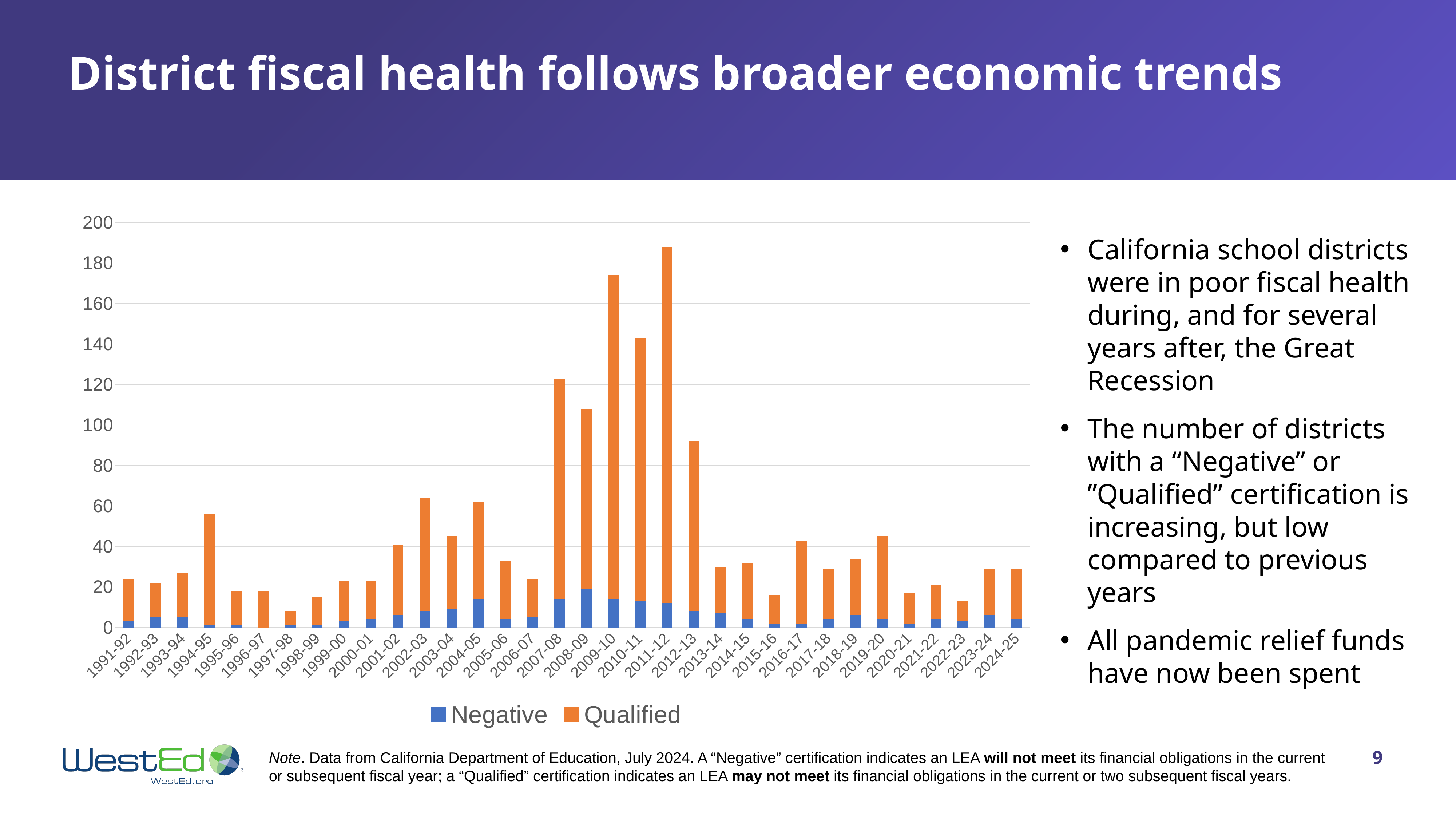
Which fiscal year has the larger total bar, 2009-10 or 2010-11? 2009-10 Is the total bar height for 2011-12 greater or less than 180? greater What kind of chart is shown on the slide? Stacked bar chart Which fiscal year has the tallest stacked bar in the chart? 2011-12 Which fiscal year has the larger total bar, 1994-95 or 1995-96? 1994-95 What are the two series named in the chart legend? Negative and Qualified Which fiscal year has the shortest stacked bar in the chart? 1997-98 Is the total bar height for 2009-10 greater or less than 160? greater How many fiscal years are shown along the x axis of the chart? 34 Which fiscal year has the largest Negative (blue) segment in the chart? 2008-09 Is the total bar height for 2015-16 greater or less than 20? less How many series does the chart legend list? 2